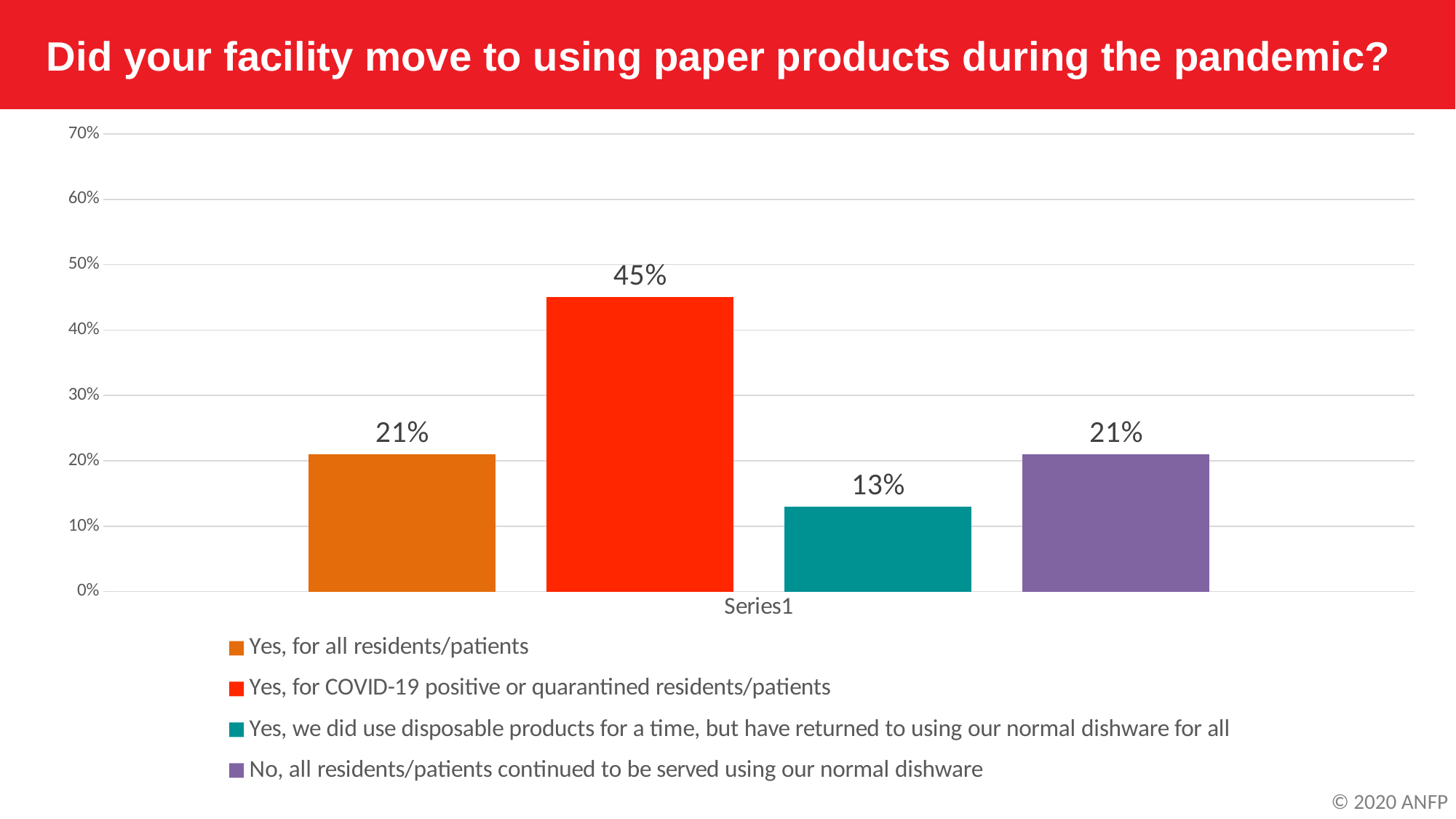
Which response has the lowest percentage? Yes, we did use disposable products for a time, but have returned to using our normal dishware for all What percentage of respondents said yes, for all residents/patients? 21% What percentage of respondents said no, all residents/patients continued to be served using normal dishware? 21% What percentage of respondents said yes, for COVID-19 positive or quarantined residents/patients? 45% Is the value for 'Yes, for COVID-19 positive or quarantined residents/patients' greater or less than 40%? greater How many response categories are shown in the chart? 4 What is the difference in percentage points between the 'Yes, for COVID-19 positive or quarantined residents/patients' response and the 'Yes, for all residents/patients' response? 24 percentage points What type of chart is shown on the slide? Bar chart What colour is the bar for 'No, all residents/patients continued to be served using our normal dishware'? Purple Which is larger: the percentage for 'Yes, for all residents/patients' or the percentage for 'Yes, we did use disposable products for a time, but have returned to using our normal dishware for all'? Yes, for all residents/patients Which response has the highest percentage? Yes, for COVID-19 positive or quarantined residents/patients What percentage of respondents said they used disposable products for a time but have returned to normal dishware for all? 13%